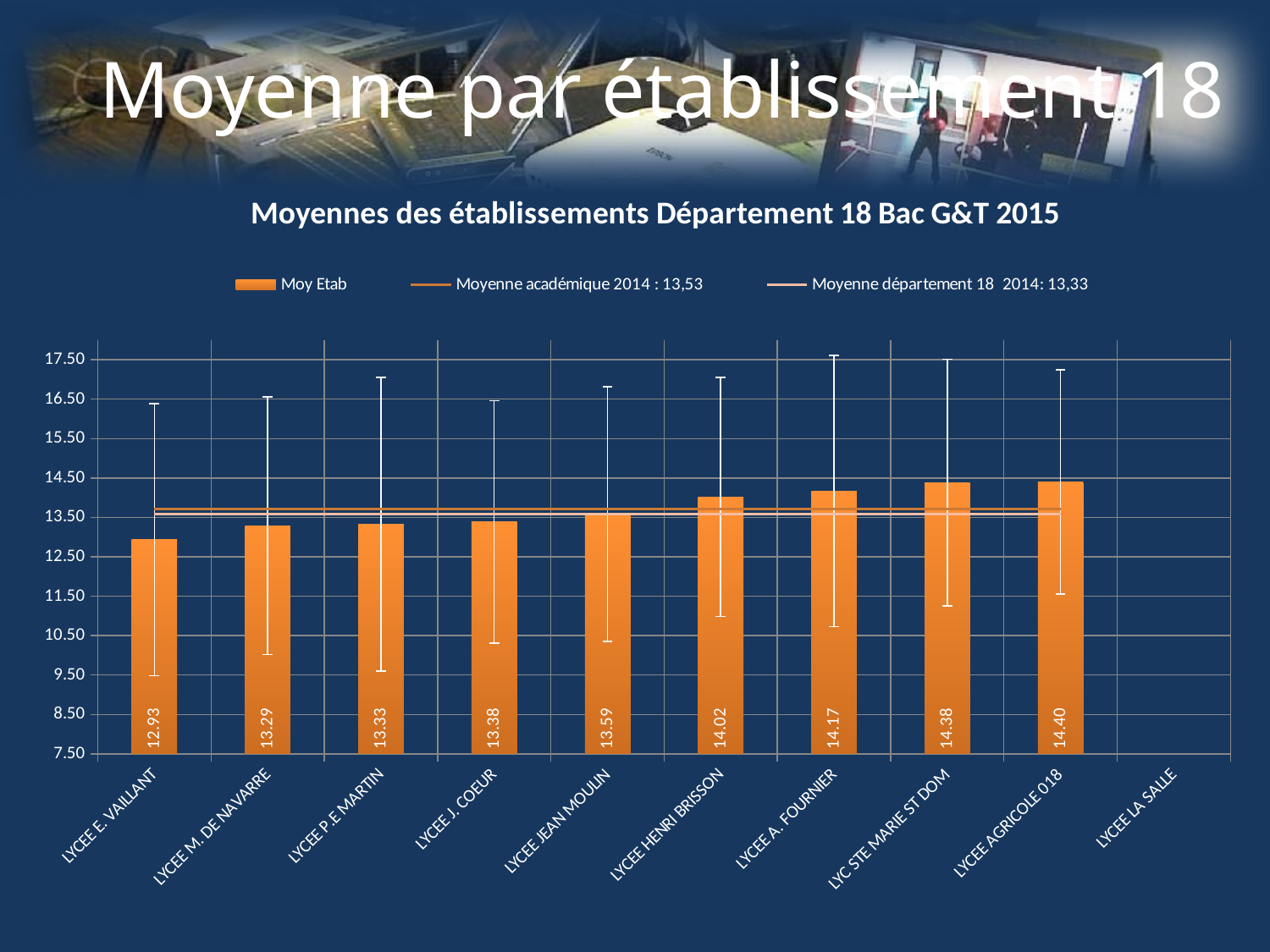
How many bars are plotted in the chart? 9 What is the value for LYCEE E. VAILLANT? 12.93 What is the difference between the values for LYCEE AGRICOLE 018 and LYCEE E. VAILLANT? 1.47 Is the value for LYCEE M. DE NAVARRE greater or less than 13.50? less What kind of chart is shown? combination bar and line chart What is the value for LYC STE MARIE ST DOM? 14.38 Which establishment has the highest value? LYCEE AGRICOLE 018 Which establishment has the lowest value? LYCEE E. VAILLANT What is the value for LYCEE HENRI BRISSON? 14.02 How many series does the legend list? 3 Do the bar values rise or fall from left to right along the x axis? rise Which is larger, the value for LYCEE JEAN MOULIN or the value for LYCEE A. FOURNIER? LYCEE A. FOURNIER